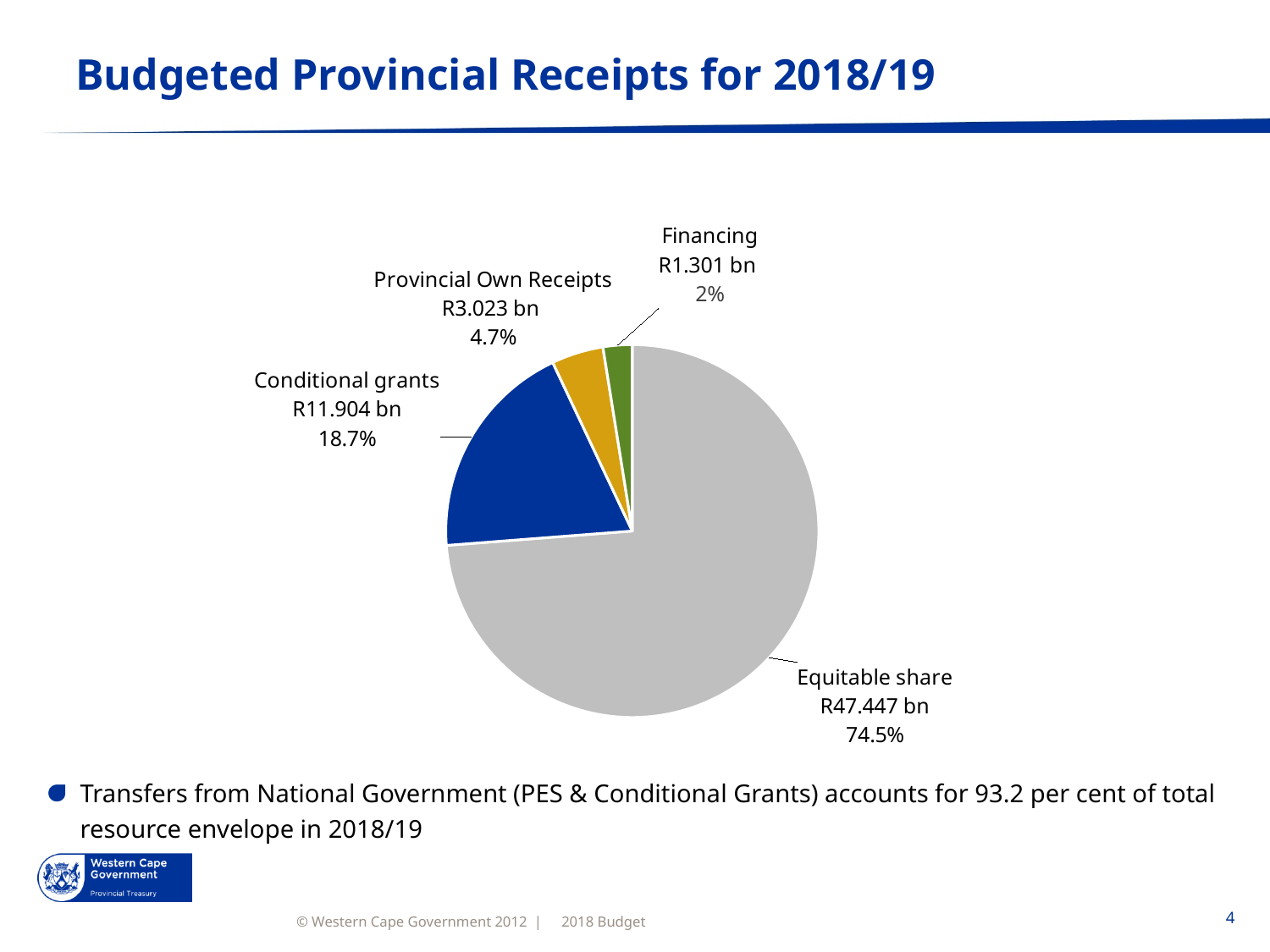
What share of the pie does Conditional grants represent? 18.7% What is the budgeted amount for Financing? R1.301 bn What share of the pie does Financing represent? 2% What is the budgeted amount for Conditional grants? R11.904 bn What type of chart is shown on the slide? Pie chart Which category has the largest slice of the pie? Equitable share Which is larger, Conditional grants or Provincial Own Receipts? Conditional grants How many slices does the pie chart have? 4 What is the budgeted amount for Equitable share? R47.447 bn What is the budgeted amount for Provincial Own Receipts? R3.023 bn What share of the pie does Equitable share represent? 74.5% Which category has the smallest slice of the pie? Financing